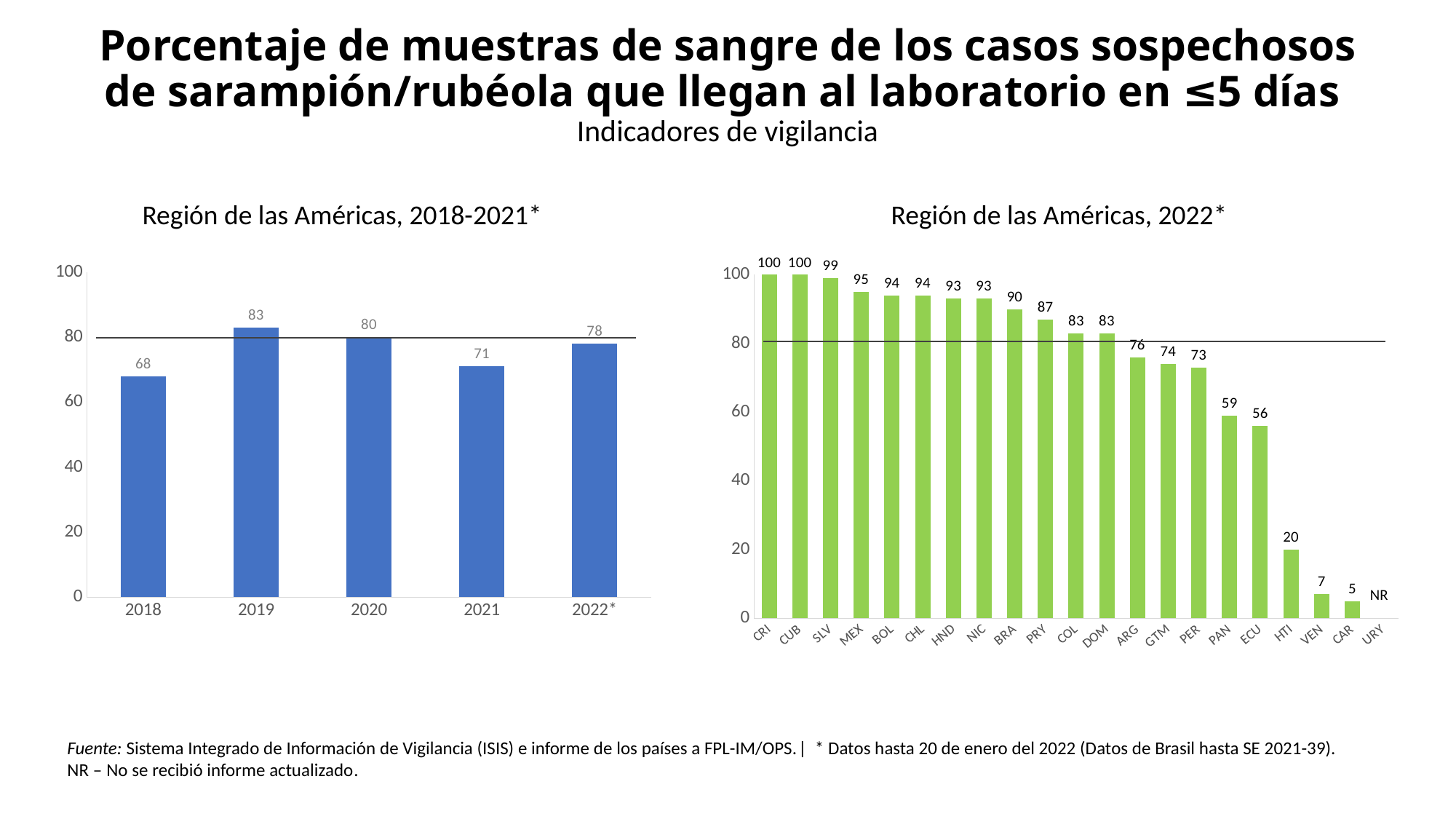
In the 'Región de las Américas, 2022*' chart, what label is shown for URY instead of a value? NR What type of chart is the 'Región de las Américas, 2022*' chart? bar chart In the 'Región de las Américas, 2018-2021*' chart, what is the value for 2019? 83 In the 'Región de las Américas, 2022*' chart, which country has the lowest plotted value? CAR In the 'Región de las Américas, 2018-2021*' chart, how many bars are plotted? 5 In the 'Región de las Américas, 2018-2021*' chart, is the value for 2022* larger or smaller than the value for 2020? smaller In the 'Región de las Américas, 2018-2021*' chart, what is the difference between the values for 2019 and 2021? 12 In the 'Región de las Américas, 2022*' chart, what is the value for HTI? 20 In the 'Región de las Américas, 2022*' chart, what is the difference between the values for PAN and ECU? 3 In the 'Región de las Américas, 2022*' chart, what is the value for PRY? 87 In the 'Región de las Américas, 2018-2021*' chart, which year has the lowest value? 2018 In the 'Región de las Américas, 2022*' chart, which is larger, the value for ARG or the value for PER? ARG